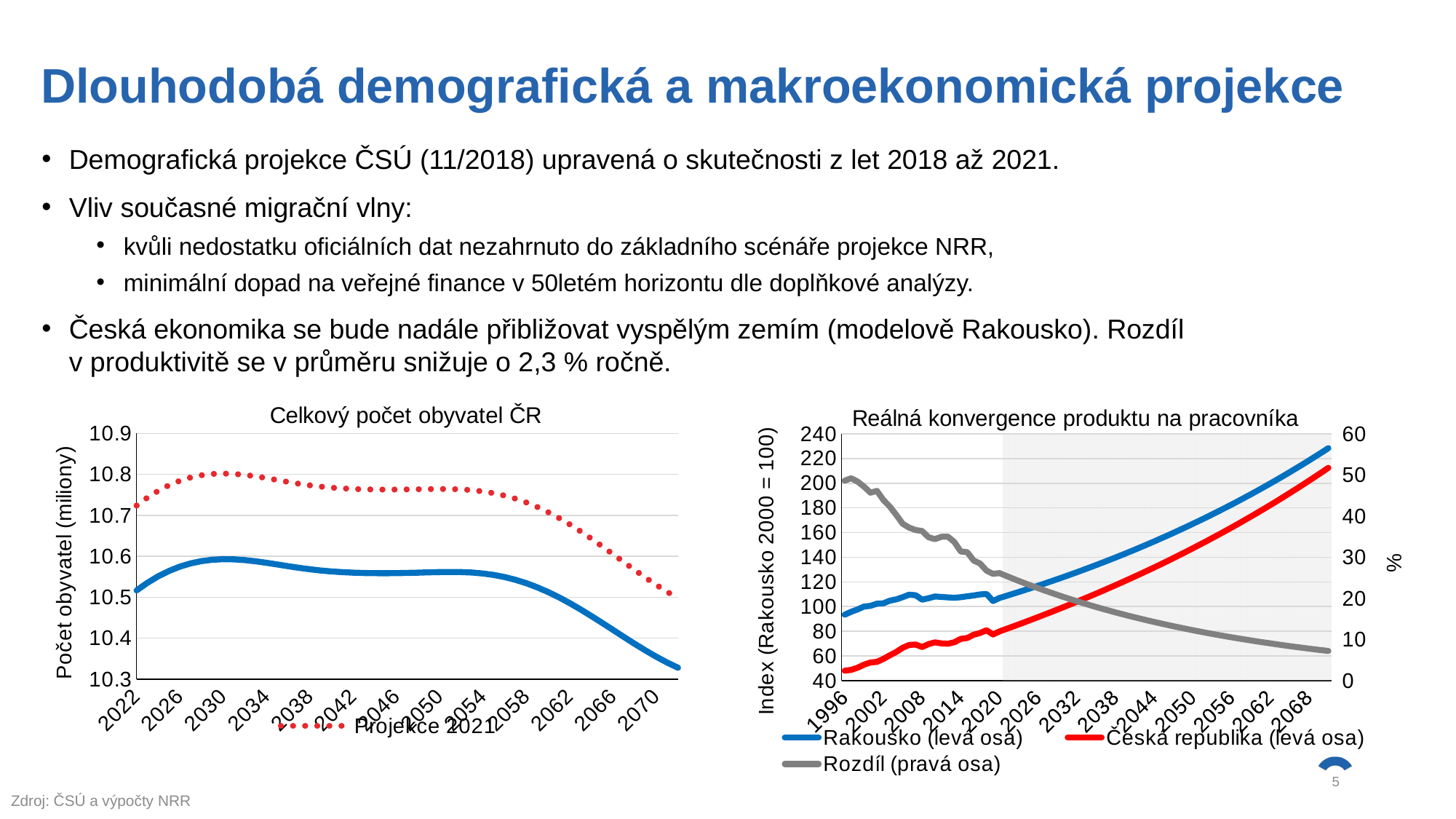
In the left chart "Celkový počet obyvatel ČR", is the value of the solid blue line in 2070 greater or less than 10.4? less In the right chart "Reálná konvergence produktu na pracovníka", which series has the higher value in 2068, Rakousko (levá osa) or Česká republika (levá osa)? Rakousko (levá osa) In the right chart "Reálná konvergence produktu na pracovníka", does the Rozdíl (pravá osa) series rise or fall from 1996 to 2068? fall In the right chart "Reálná konvergence produktu na pracovníka", does the Rakousko (levá osa) series rise or fall from 1996 to 2068? rise In the right chart "Reálná konvergence produktu na pracovníka", is the value for Česká republika (levá osa) in 1996 greater or less than 60? less In the right chart "Reálná konvergence produktu na pracovníka", how many series does the legend list? 3 In the right chart "Reálná konvergence produktu na pracovníka", is the value for Rakousko (levá osa) in 2068 greater or less than 200? greater In the right chart "Reálná konvergence produktu na pracovníka", which series is plotted on the right axis according to the legend? Rozdíl (pravá osa) What type of chart is the right chart titled "Reálná konvergence produktu na pracovníka"? line chart What type of chart is the left chart titled "Celkový počet obyvatel ČR"? line chart